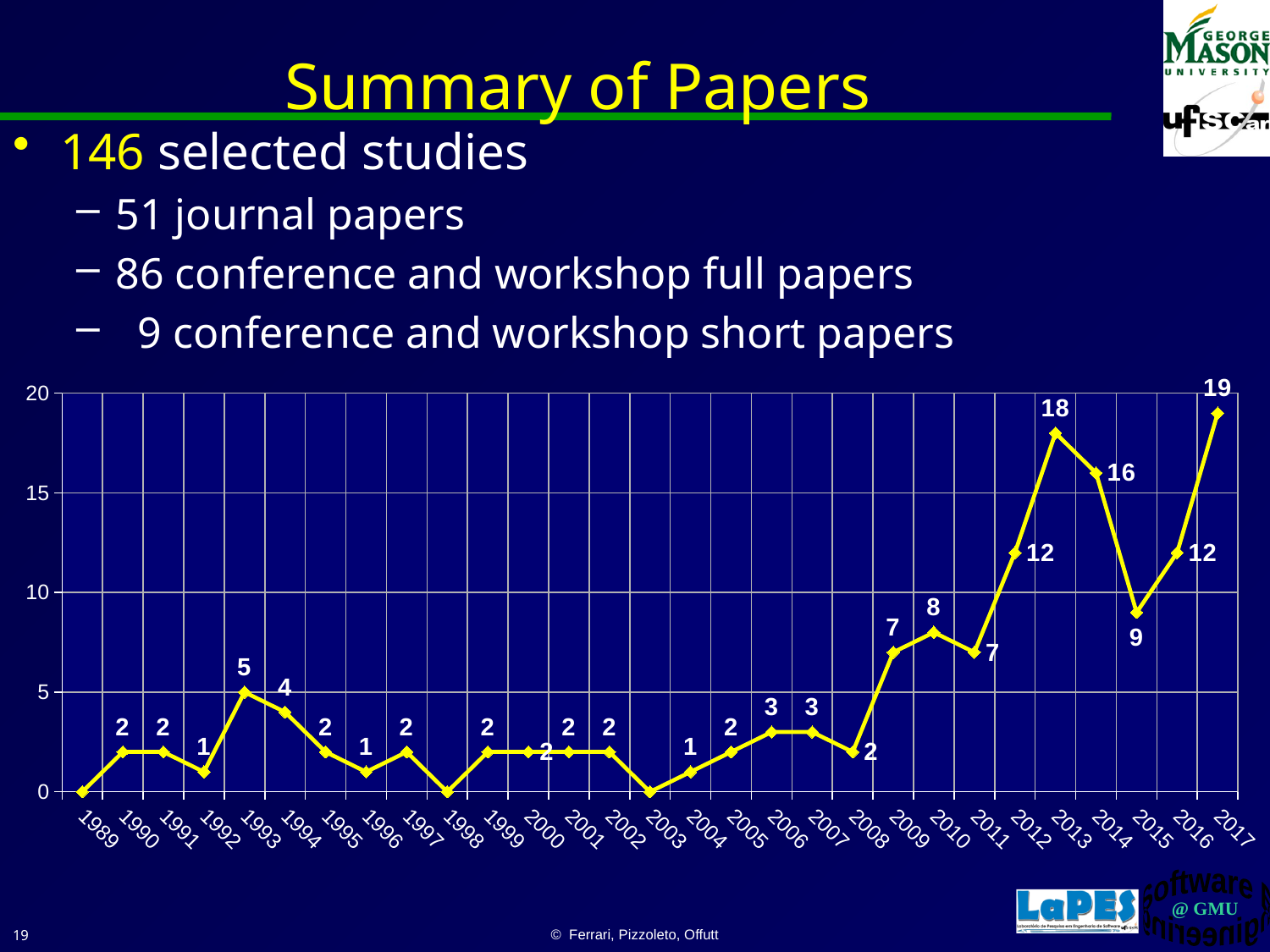
Which is larger, the value for 2012 or the value for 2014? 2014 What is the difference between the values for 2017 and 2013? 1 How many years are plotted on the x axis? 29 What is the value for 2015? 9 What is the value for 2013? 18 What is the difference between the values for 2014 and 2015? 7 Do the values generally rise or fall from 2008 to 2013? rise What is the value for 1993? 5 Is the value for 2013 greater or less than 15? greater What is the value for 2010? 8 What kind of chart is shown on the slide? line chart Which year has the highest value? 2017